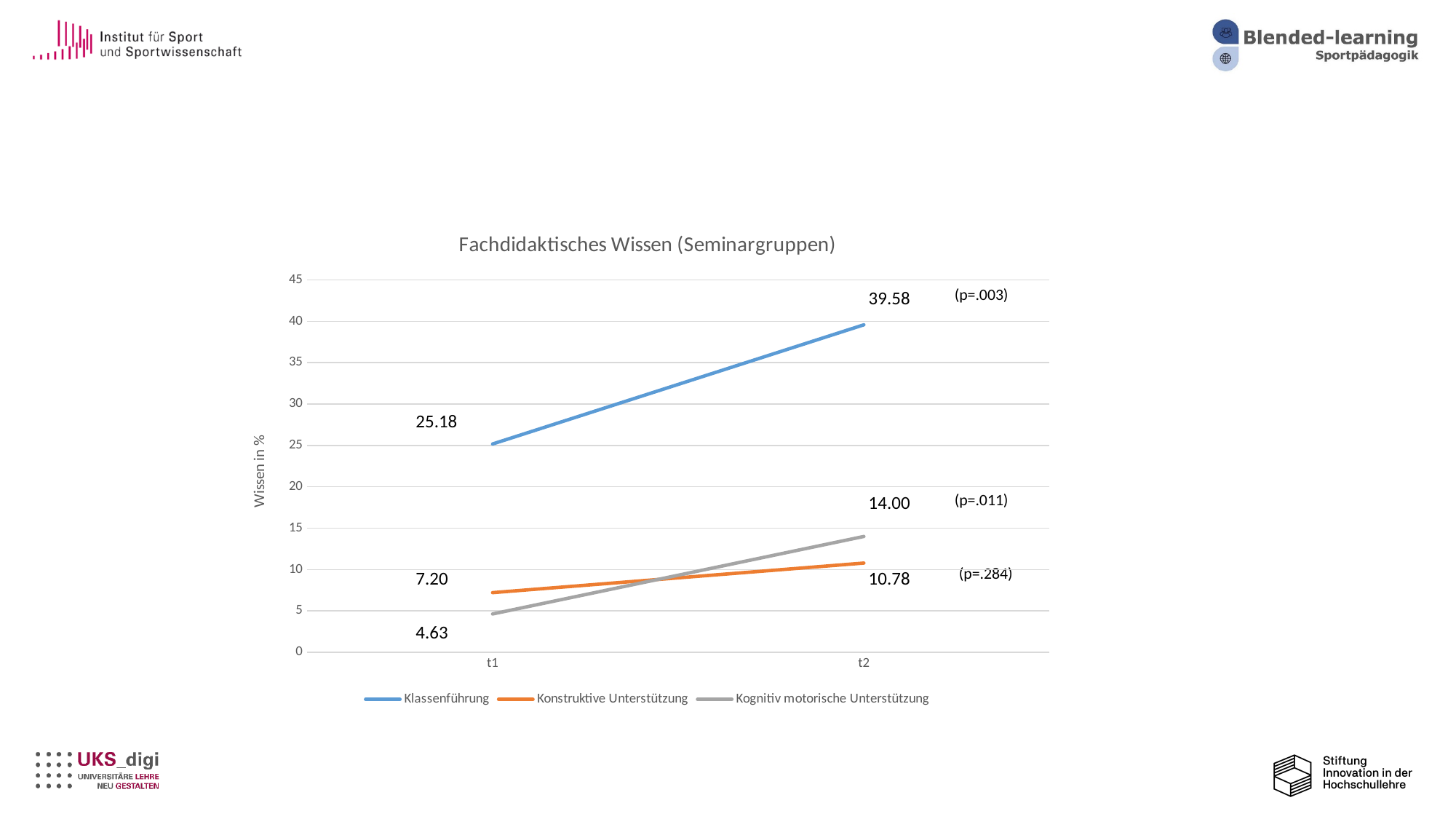
What is the value for Klassenführung at t1? 25.18 By how much does the value for Klassenführung increase from t1 to t2? 14.40 What is the value for Kognitiv motorische Unterstützung at t1? 4.63 Does the value for Kognitiv motorische Unterstützung rise or fall from t1 to t2? rise How many series does the legend list? 3 What is the value for Konstruktive Unterstützung at t2? 10.78 What type of chart is shown on the slide? line chart Which series has the highest value at t2? Klassenführung At t2, which is larger: Konstruktive Unterstützung or Kognitiv motorische Unterstützung? Kognitiv motorische Unterstützung What is the value for Klassenführung at t2? 39.58 Which series has the lowest value at t1? Kognitiv motorische Unterstützung What is the title of the chart? Fachdidaktisches Wissen (Seminargruppen)